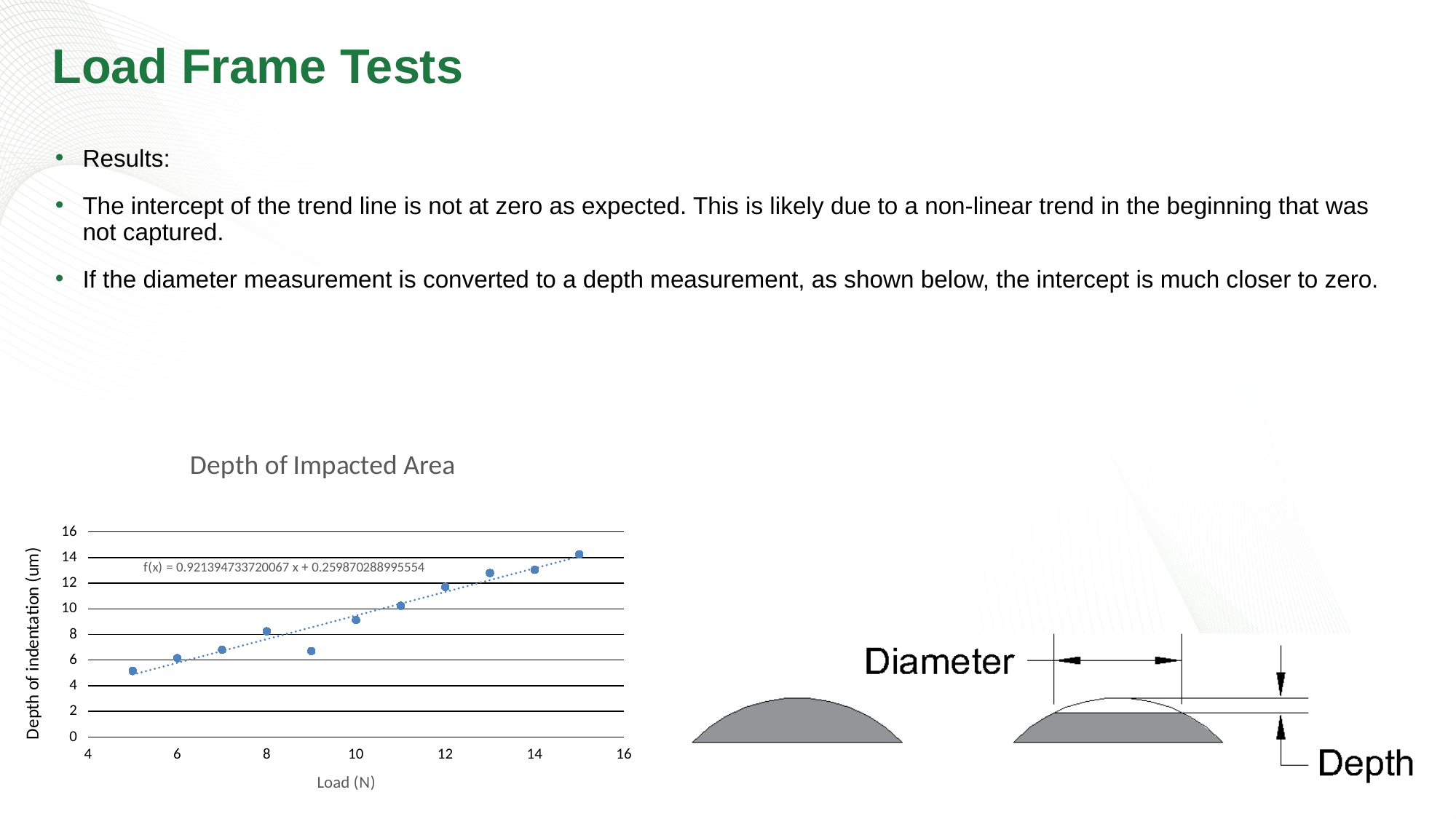
What is the title of the chart on the slide? Depth of Impacted Area Is the depth of indentation at a load of 15 N greater or less than 12? greater At which load is the depth of indentation highest? 15 What kind of chart is shown on the slide? Scatter chart Is the depth of indentation at a load of 13 N greater or less than 12? greater What is the label of the x axis of the chart? Load (N) At which load is the depth of indentation lowest? 5 Do the depth values generally rise or fall as the load increases along the x axis? Rise How many data points are plotted in the chart? 11 Is the depth of indentation at a load of 9 N greater or less than 8? less Which has the larger depth of indentation: the point at a load of 9 N or the point at a load of 10 N? 10 N